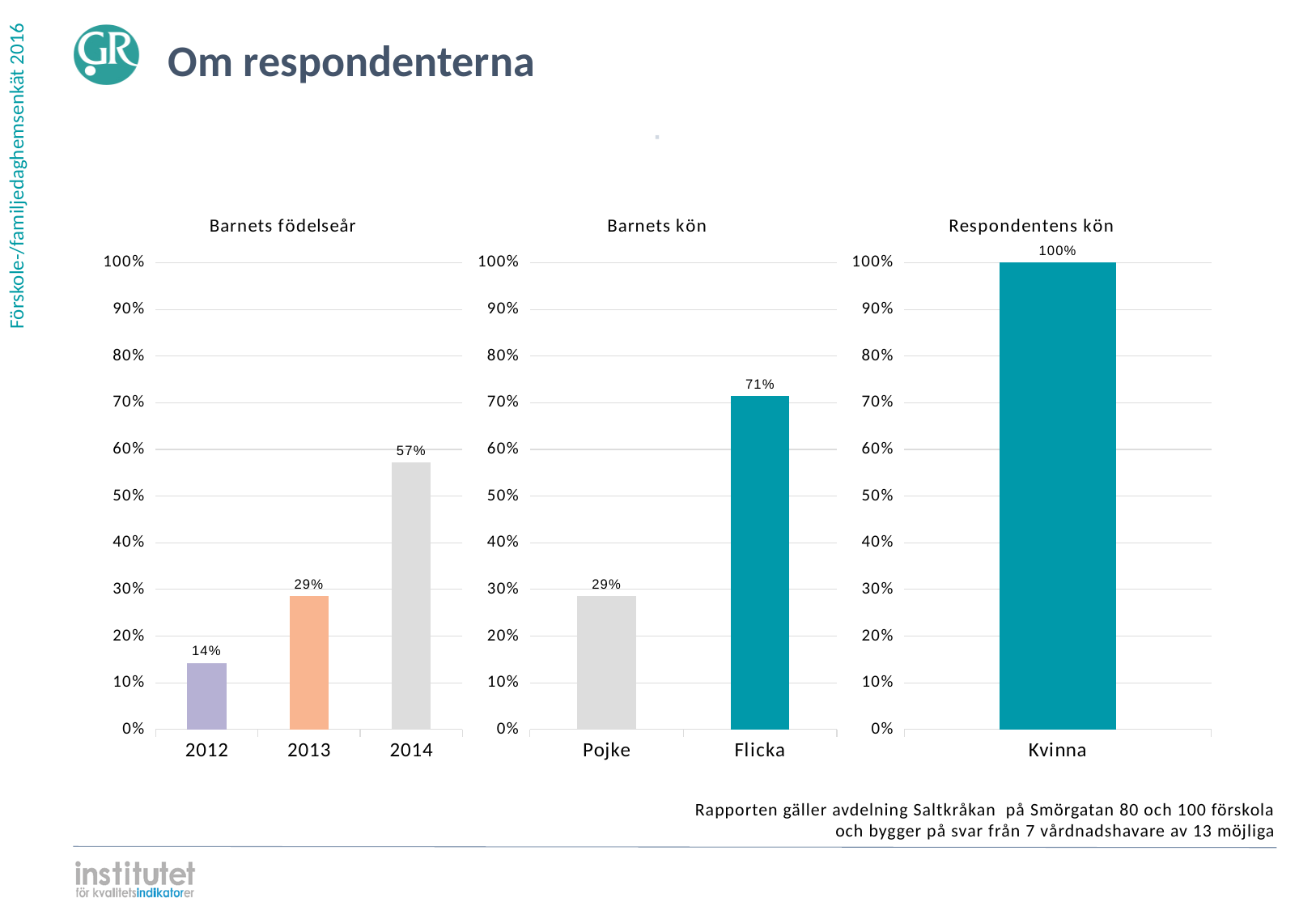
In the 'Barnets födelseår' chart, do the values rise or fall from 2012 to 2014? rise In the 'Barnets kön' chart, which is larger, Pojke or Flicka? Flicka In the 'Barnets födelseår' chart, what is the value for 2014? 57% In the 'Barnets födelseår' chart, which year has the highest value? 2014 In the 'Barnets födelseår' chart, what is the difference between the values for 2014 and 2013? 28% In the 'Barnets födelseår' chart, which year has the lowest value? 2012 In the 'Barnets kön' chart, what is the value for Flicka? 71% In the 'Barnets födelseår' chart, what is the value for 2012? 14% In the 'Respondentens kön' chart, what is the value for Kvinna? 100% In the 'Barnets kön' chart, what is the difference between Flicka and Pojke? 42% How many categories are shown in the 'Barnets födelseår' chart? 3 What kind of chart is the 'Barnets kön' chart? bar chart